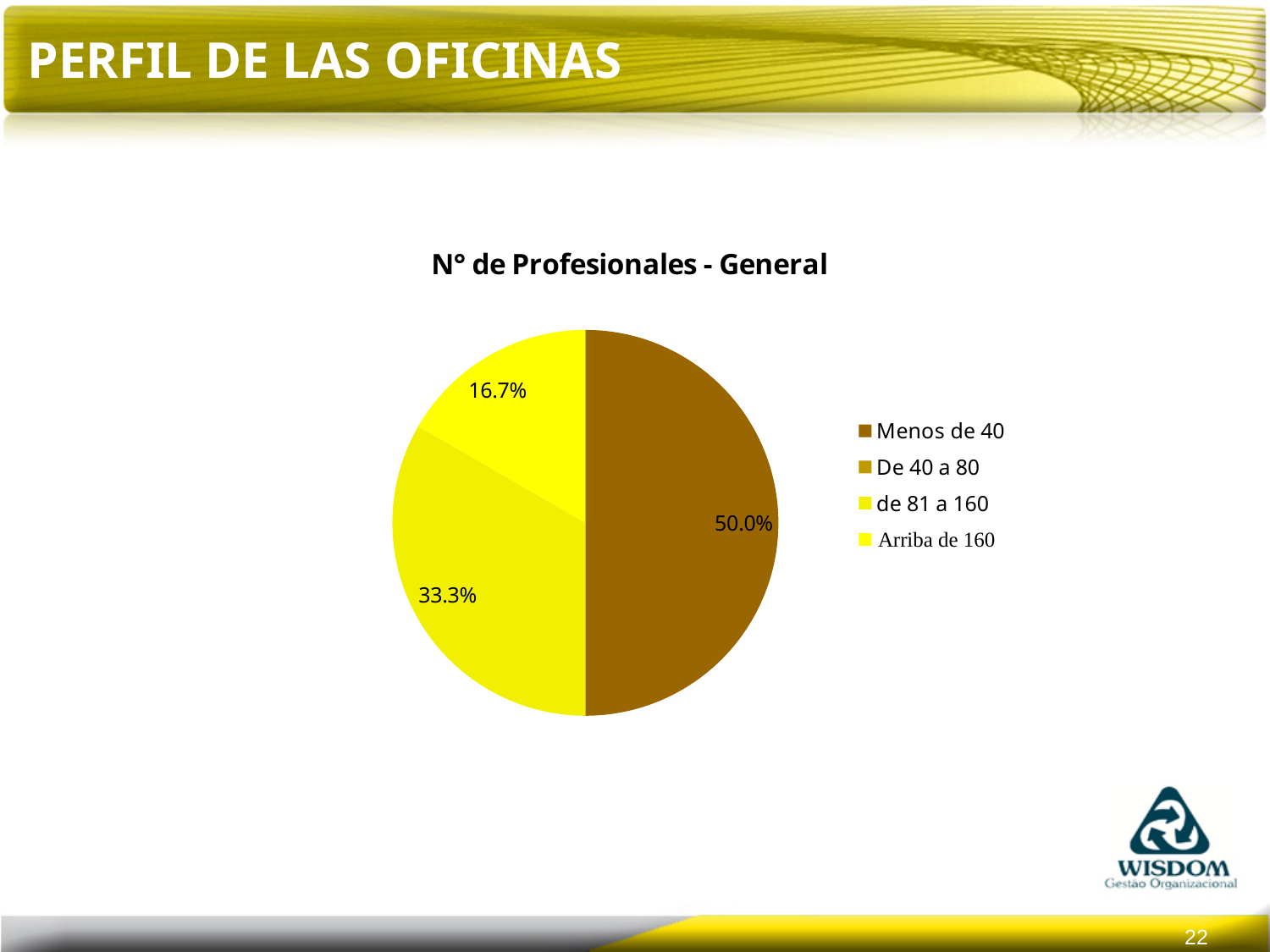
Which of the labelled slices is the smallest? Arriba de 160 What is the title of the chart? N° de Profesionales - General What share of the pie does the 'Menos de 40' slice represent? 50.0% How many percentage labels are printed on the pie? 3 What share of the pie does the 'de 81 a 160' slice represent? 33.3% Which category has the largest slice of the pie? Menos de 40 What kind of chart is shown on the slide? pie chart Which legend entry is listed first? Menos de 40 How many entries does the chart's legend list? 4 Which slice is larger, 'de 81 a 160' or 'Arriba de 160'? de 81 a 160 What share of the pie does the 'Arriba de 160' slice represent? 16.7% What is the difference in percentage points between the 'Menos de 40' slice and the 'de 81 a 160' slice? 16.7